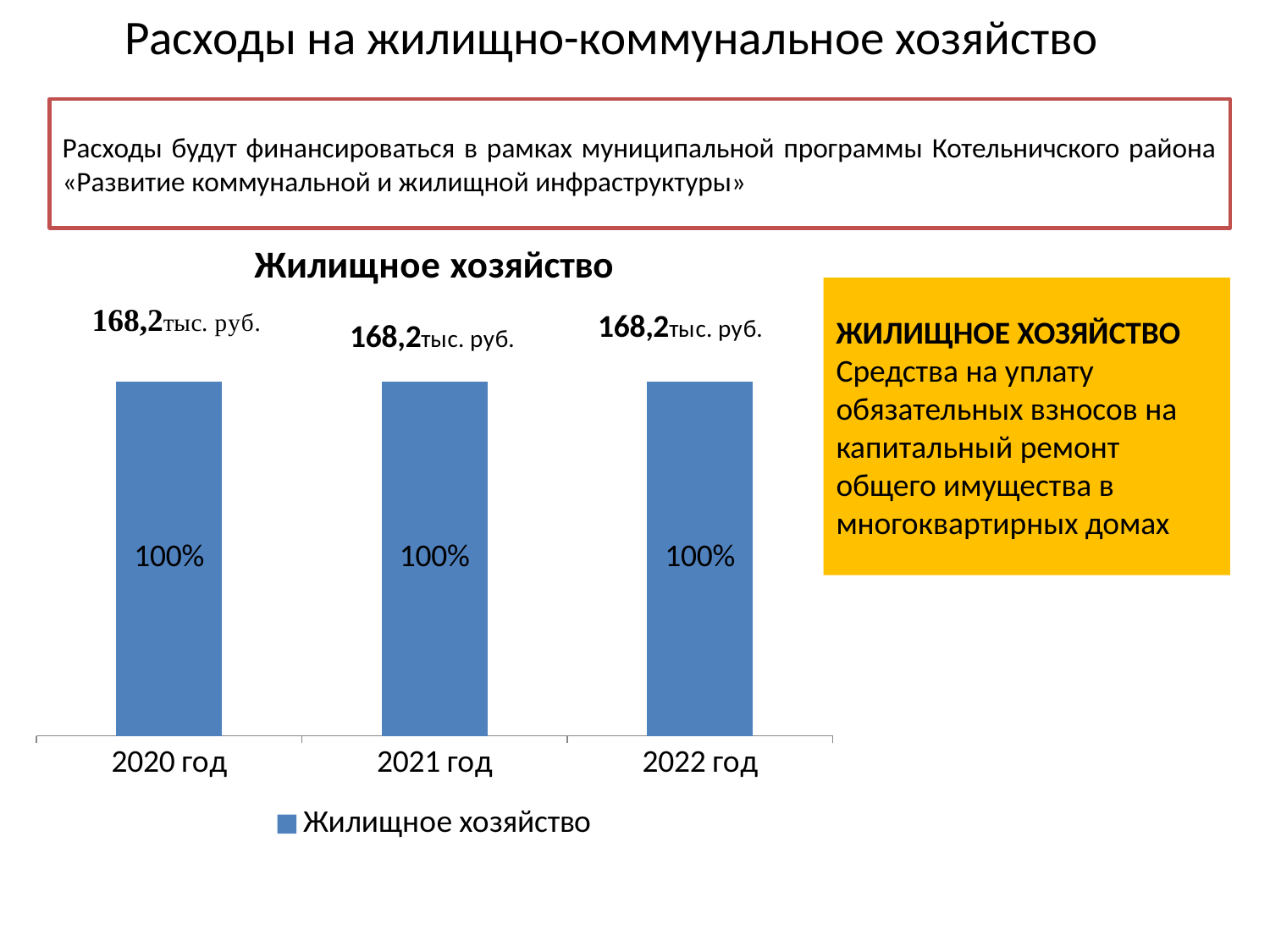
Do the values rise, fall, or stay the same from 2020 год to 2022 год? stay the same What amount in тыс. руб. is shown above the bar for 2020 год? 168,2 тыс. руб. What is the data label shown on the bar for 2022 год? 100% What series name is shown in the chart legend? Жилищное хозяйство What is the difference between the amounts shown for 2021 год and 2022 год? 0 What is the data label shown on the bar for 2021 год? 100% How many categories (years) are shown on the x axis of the chart? 3 What amount in тыс. руб. is shown above the bar for 2022 год? 168,2 тыс. руб. How many series does the chart legend list? 1 What is the data label shown on the bar for 2020 год? 100% What kind of chart is shown under the title "Жилищное хозяйство"? bar chart What is the title of the chart? Жилищное хозяйство